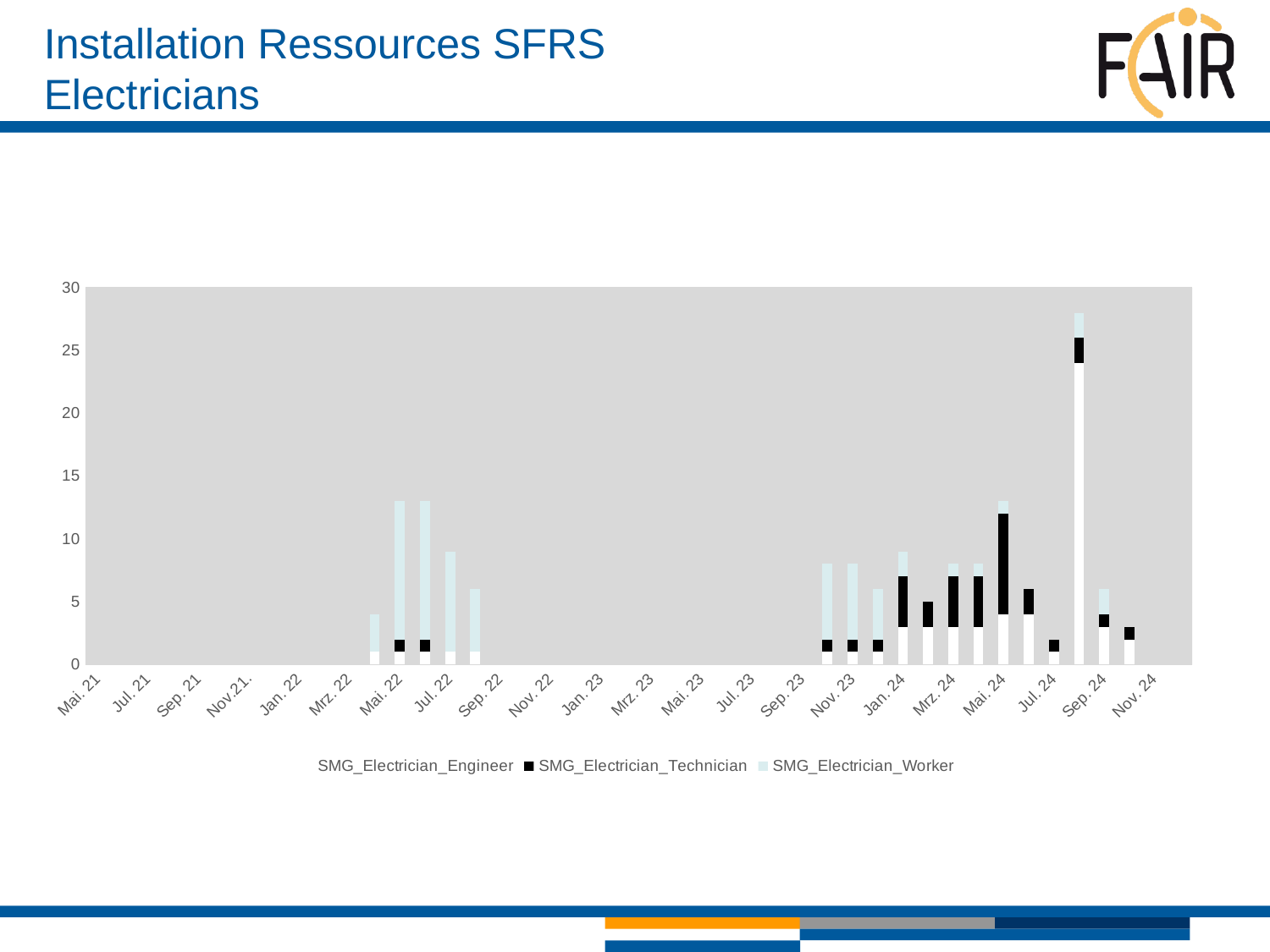
How many month labels are shown on the horizontal axis? 22 What kind of chart is shown on the slide? Stacked bar chart Is the total of the stacked bar at Mai. 22 greater or less than 10? greater Which series makes up most of the tallest stacked bar? SMG_Electrician_Engineer Is the total of the stacked bar at Jul. 22 greater or less than 15? less Which series is shown in black in the legend? SMG_Electrician_Technician Which series is shown in light blue in the legend? SMG_Electrician_Worker Is the total of the stacked bar at Nov. 23 greater or less than 5? greater How many series does the legend list? 3 What is the highest value shown on the vertical axis? 30 Are any bars plotted between Jan. 23 and Jul. 23? No